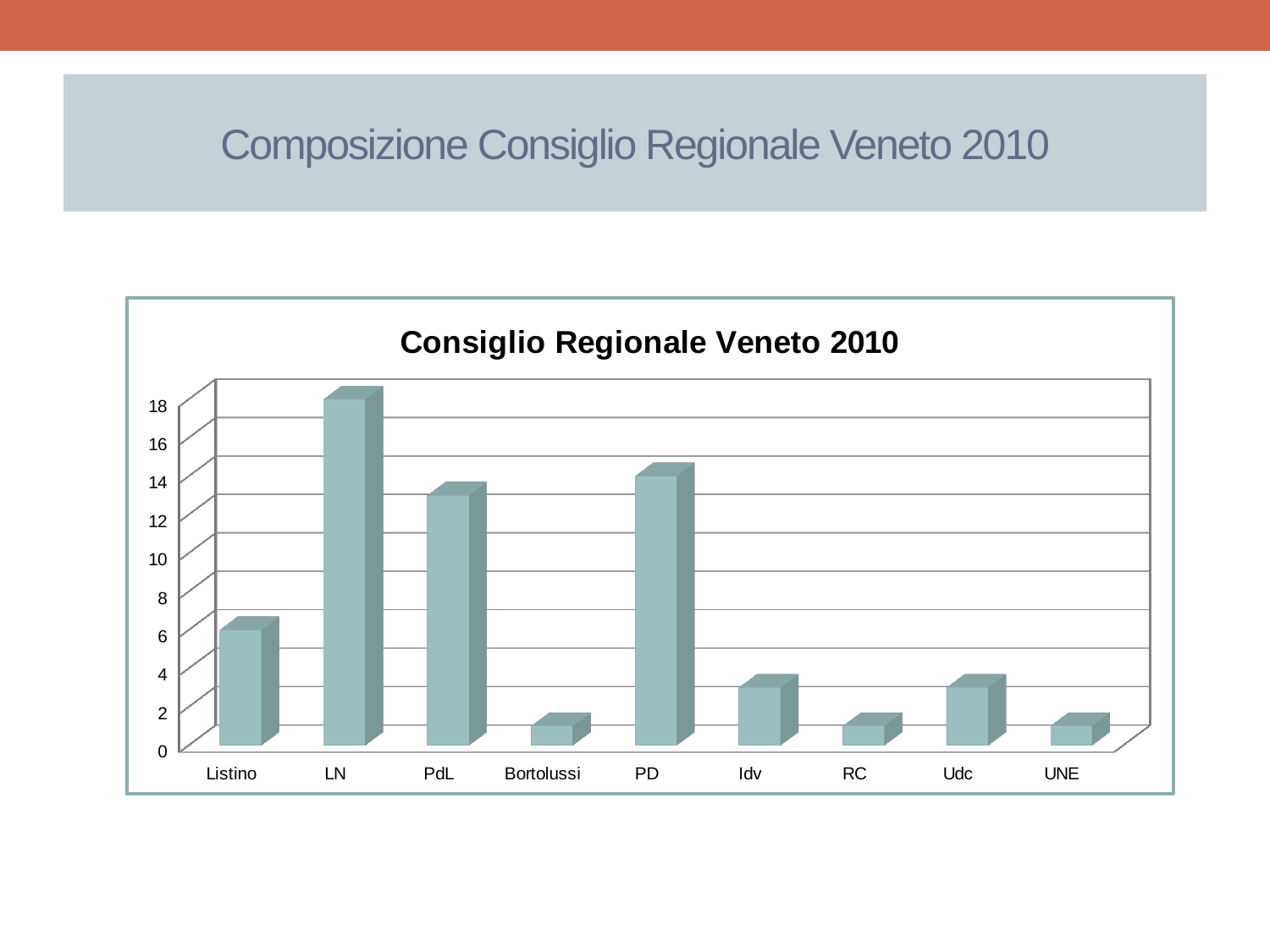
What kind of chart is shown on the slide? bar chart Which category has the highest value in the chart? LN What is the title of the chart? Consiglio Regionale Veneto 2010 What is the difference between the values for LN and PD? 4 Is the value for Idv greater or less than 4? less Is the value for PdL greater or less than 12? greater What is the value for LN? 18 Is the value for Bortolussi greater or less than 2? less What is the value for PD? 14 How many categories are shown on the x axis of the chart? 9 What is the value for Listino? 6 Which is larger, the value for Listino or the value for Udc? Listino